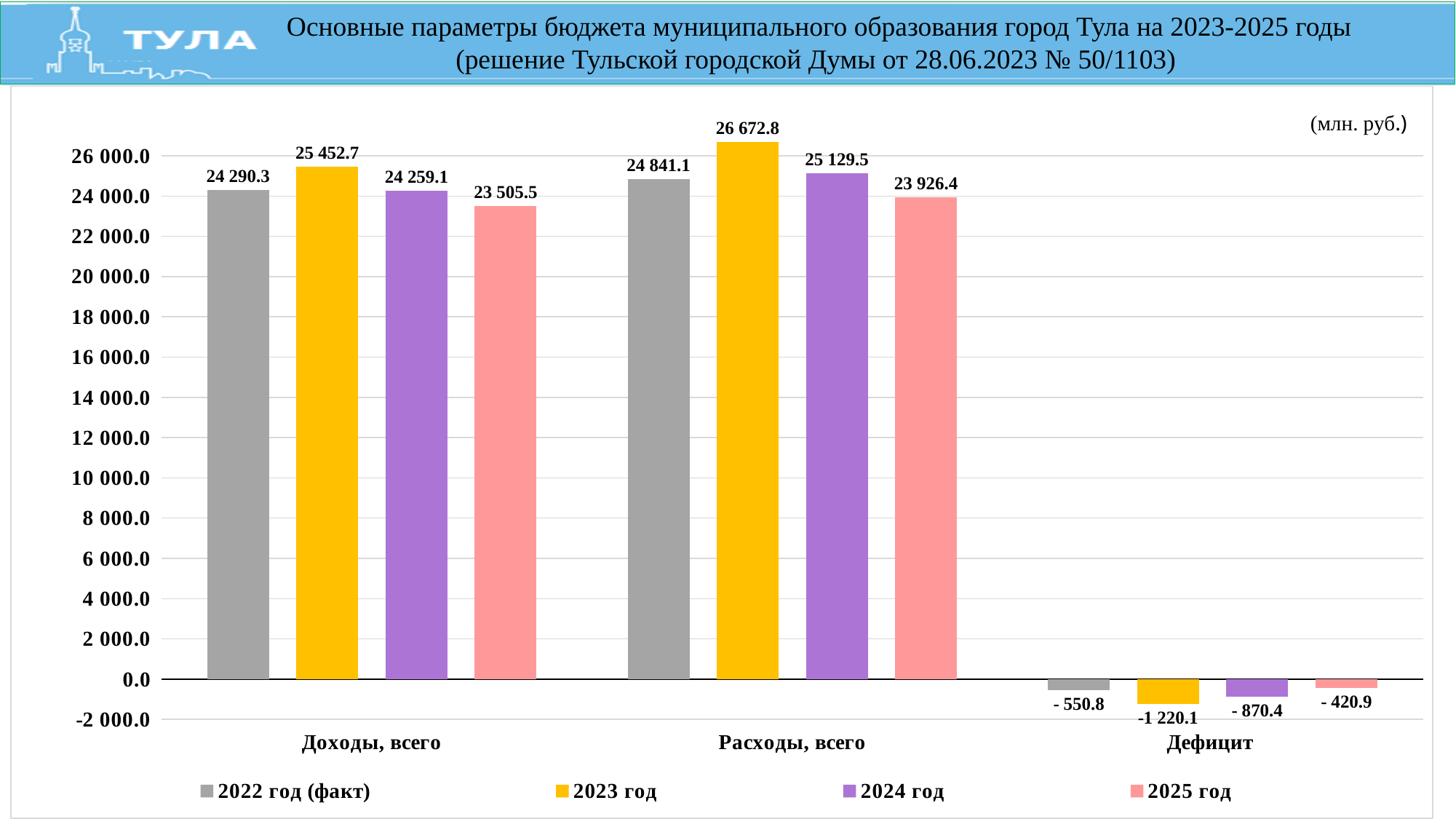
What is the value for 2023 год in the Доходы, всего category? 25 452.7 Which is larger in the Расходы, всего category: 2022 год (факт) or 2024 год? 2024 год What unit of measurement is indicated for the chart values? млн. руб. Which year has the lowest value in the Доходы, всего category? 2025 год How many series does the legend list? 4 What is the value for 2025 год in the Дефицит category? - 420.9 Is the value for 2025 год in the Доходы, всего category greater or less than 24 000.0? less Which year has the highest value in the Расходы, всего category? 2023 год What is the value for 2024 год in the Расходы, всего category? 25 129.5 What is the difference between Расходы, всего and Доходы, всего for 2023 год? 1 220.1 How many categories are shown on the x axis? 3 What kind of chart is shown on the slide? bar chart